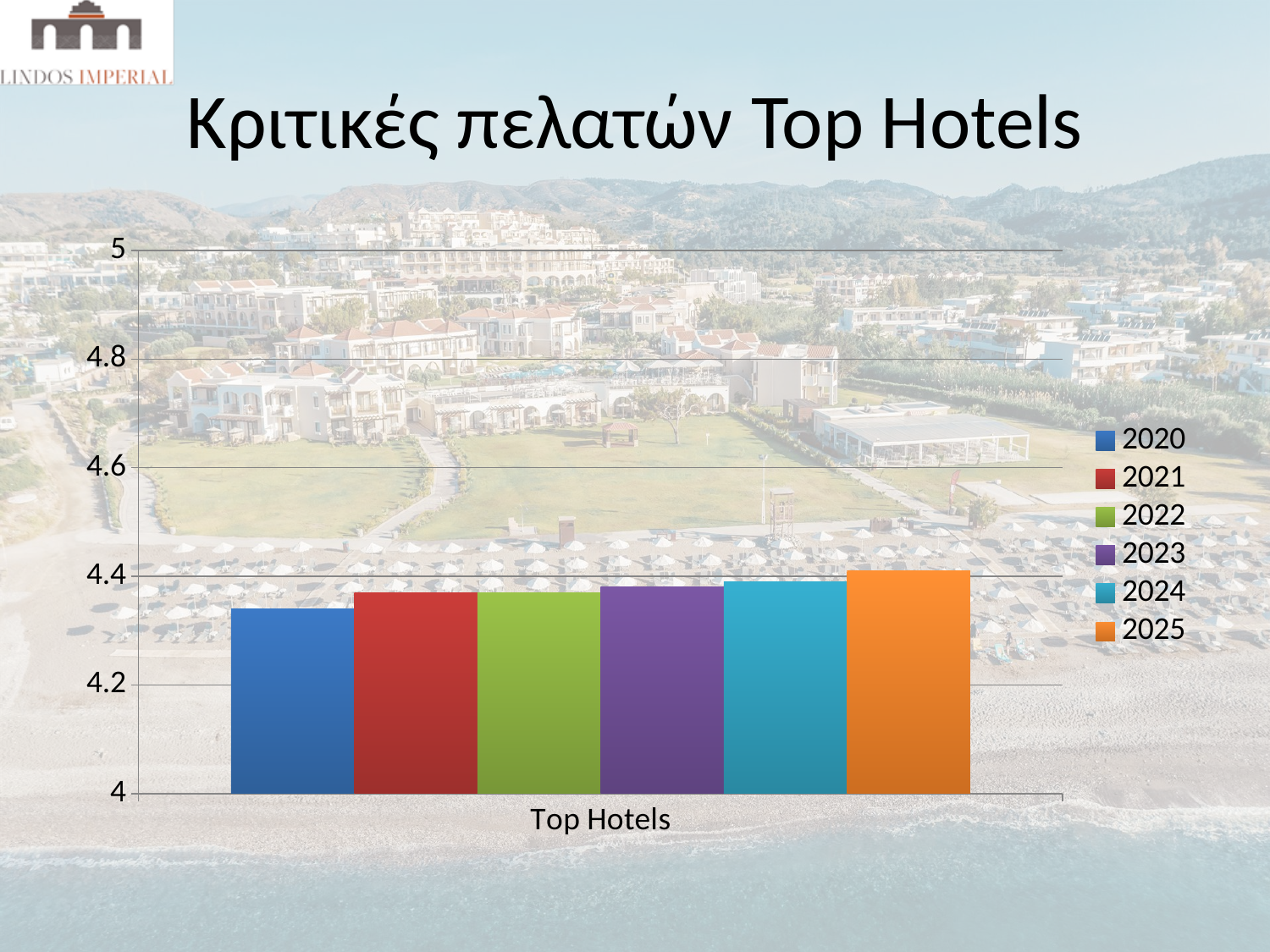
Is the value for 2020 greater or less than 4.2? greater Which year has the lowest bar? 2020 What is the category label on the x axis? Top Hotels Do the bars rise or fall from 2020 to 2025? rise Which is larger, the value for 2020 or the value for 2025? 2025 What kind of chart is shown on the slide? bar chart Which year has the highest bar? 2025 Which year is shown in orange in the legend? 2025 How many categories are shown on the x axis? 1 How many series does the legend list? 6 Is the value for 2023 greater or less than 4.6? less Is the value for 2020 greater or less than 4.4? less